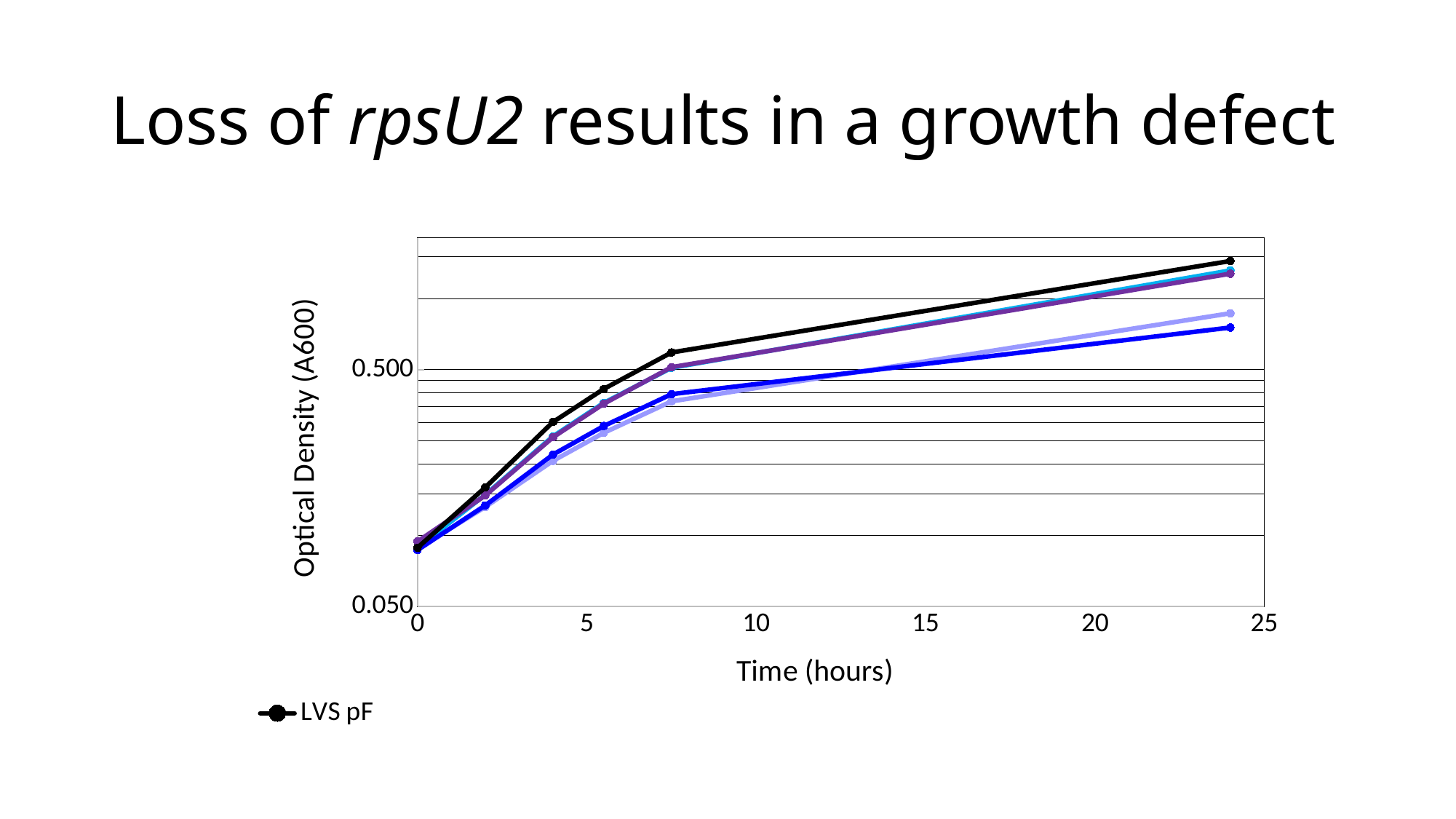
What kind of chart is shown on the slide? line chart Is the value for LVS pF at 0 hours greater or less than 0.500? less Is the value for LVS pF at 4 hours greater or less than 0.500? less How many series does the legend list? 1 How many lines are plotted on the chart? 5 How many data points does the LVS pF series have? 6 What is the label of the x axis? Time (hours) Does the optical density of LVS pF rise or fall as time increases? rise Which series has the highest optical density at 24 hours? LVS pF Is the value for LVS pF at 24 hours greater or less than 0.500? greater What is the lowest value shown on the y axis? 0.050 What is the title of the chart on the slide? Loss of rpsU2 results in a growth defect